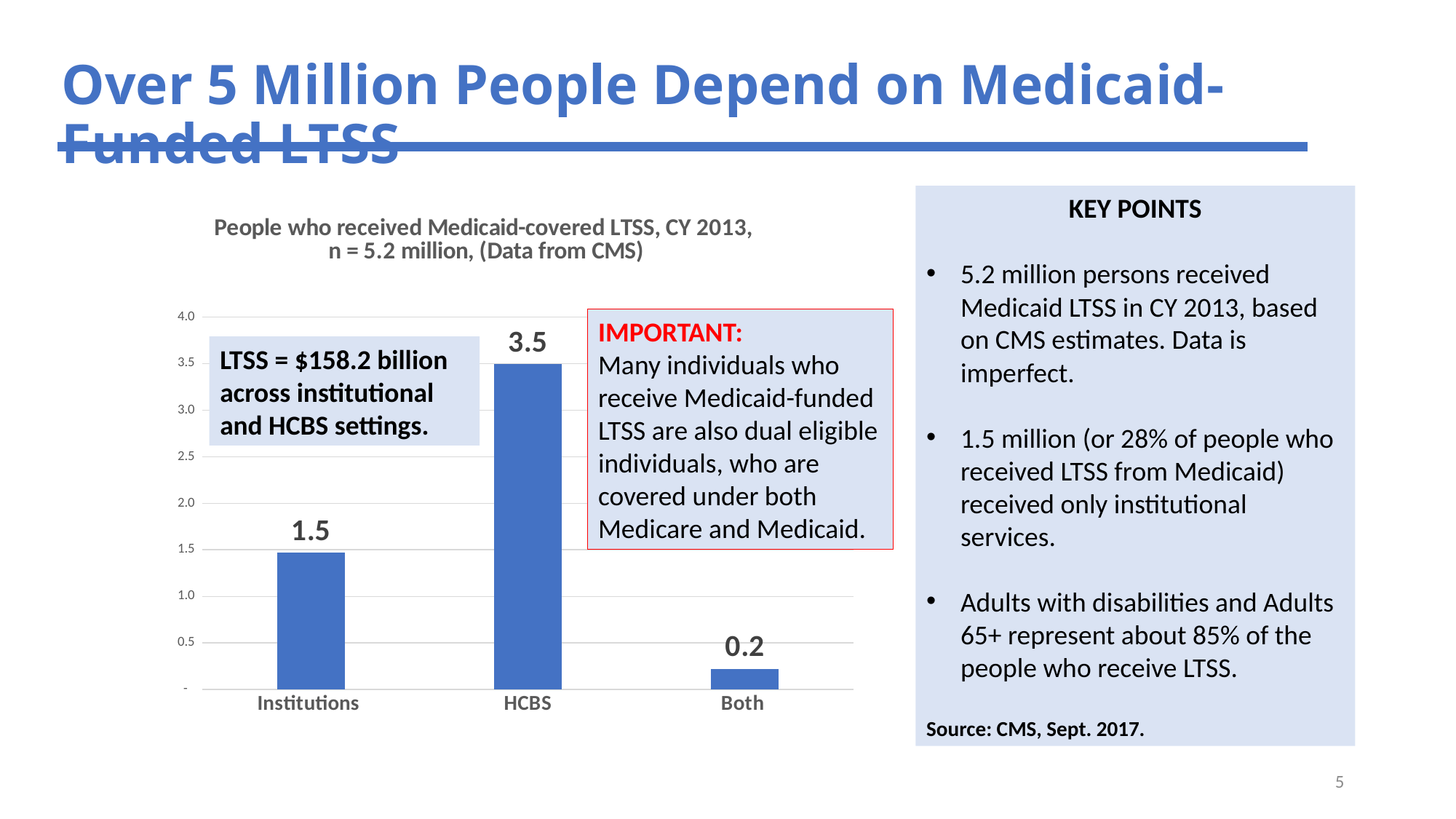
Which category has the highest value? HCBS What is the title of the chart? People who received Medicaid-covered LTSS, CY 2013, n = 5.2 million, (Data from CMS) What is the value for Institutions? 1.5 Which is larger, the value for Institutions or the value for Both? Institutions What is the difference between the values for HCBS and Institutions? 2.0 What kind of chart is shown on the slide? bar chart Is the value for HCBS greater or less than 3.0? greater What is the difference between the values for Institutions and Both? 1.3 How many categories are shown on the x axis? 3 What is the value for Both? 0.2 What is the value for HCBS? 3.5 Which category has the lowest value? Both